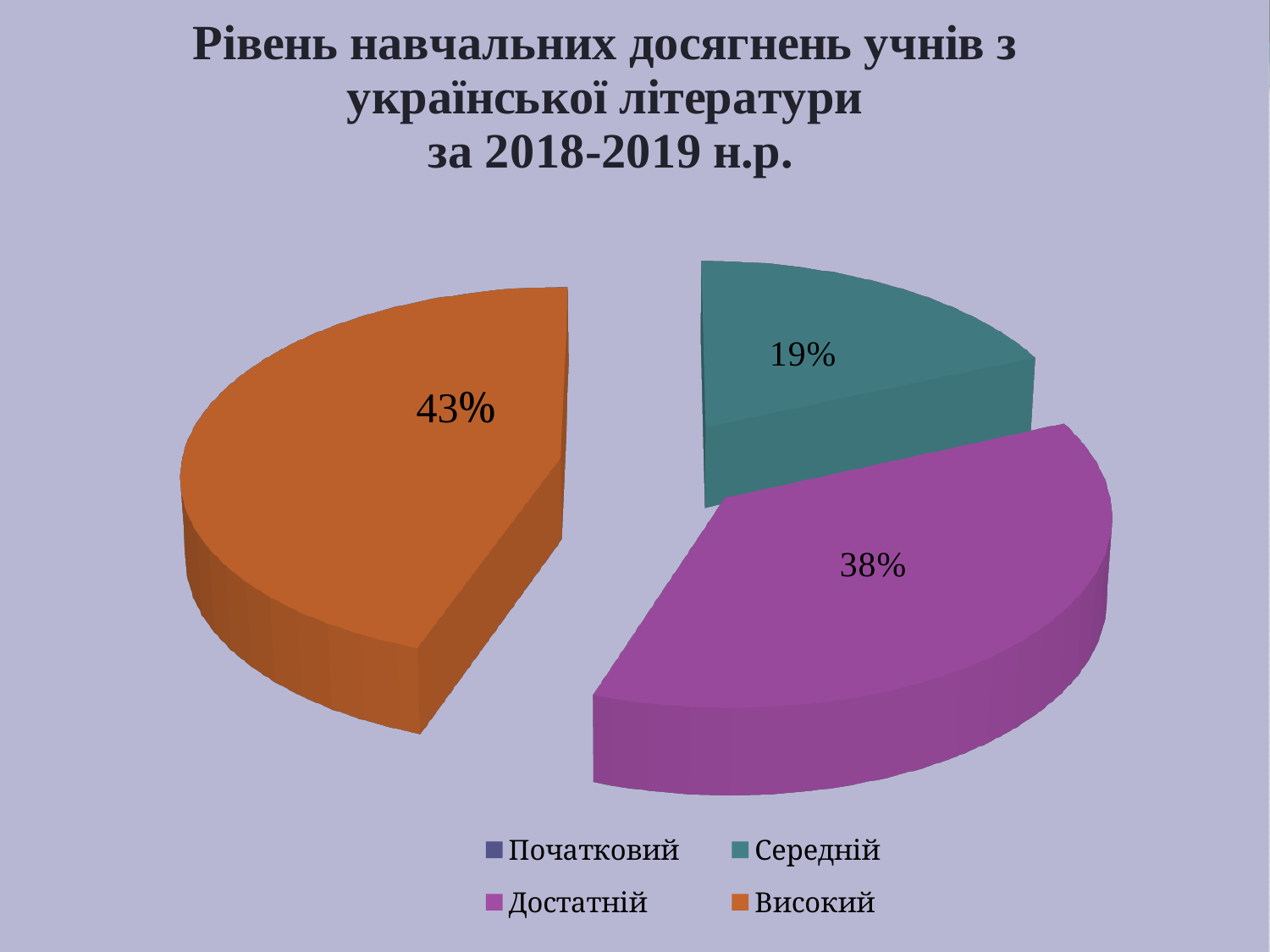
What colour is the slice for Високий? Orange Which is larger, the share for Достатній or the share for Середній? Достатній What is the difference in percentage points between Достатній and Середній? 19 How many categories does the legend list? 4 What is the difference in percentage points between Високий and Достатній? 5 What share of the pie does Середній have? 19% What share of the pie does Високий have? 43% Which legend entry has no visible slice in the pie? Початковий What kind of chart is shown on the slide? Pie chart Which visible slice of the pie is the smallest? Середній Which category has the largest slice of the pie? Високий What share of the pie does Достатній have? 38%